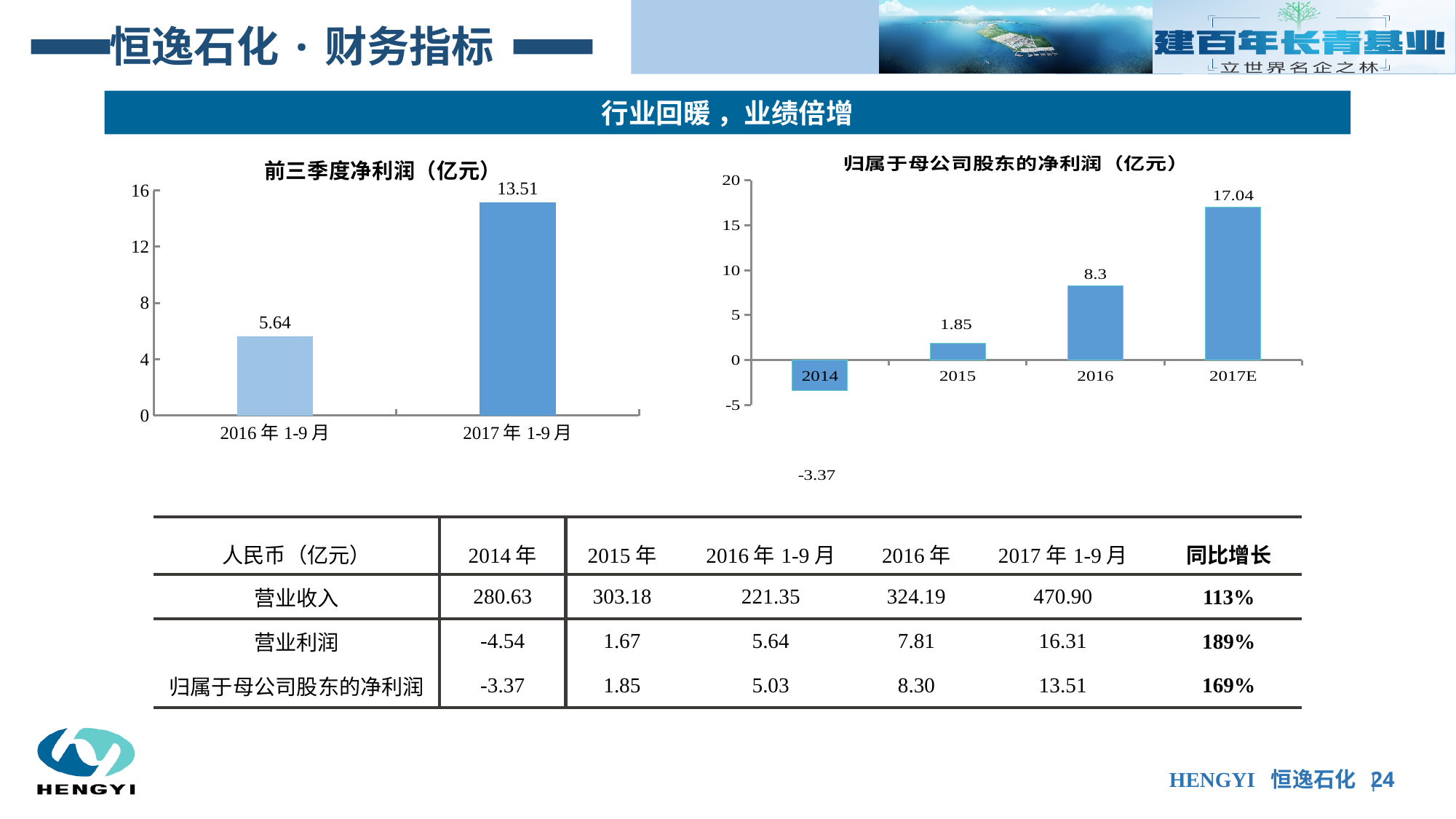
In the chart titled 归属于母公司股东的净利润（亿元）, do the values rise or fall from 2014 to 2017E? Rise What kind of chart is the one titled 前三季度净利润（亿元）? Bar chart In the chart titled 前三季度净利润（亿元）, what is the difference between the 2017年1-9月 and 2016年1-9月 values? 7.87 In the chart titled 前三季度净利润（亿元）, what is the value for 2017年1-9月? 13.51 In the chart titled 归属于母公司股东的净利润（亿元）, what is the value for 2017E? 17.04 In the chart titled 归属于母公司股东的净利润（亿元）, which year has the highest value? 2017E In the chart titled 前三季度净利润（亿元）, what is the value for 2016年1-9月? 5.64 In the chart titled 归属于母公司股东的净利润（亿元）, what is the difference between the 2016 and 2015 values? 6.45 In the chart titled 前三季度净利润（亿元）, how many bars are plotted? 2 In the chart titled 归属于母公司股东的净利润（亿元）, how many categories are shown on the x axis? 4 In the chart titled 归属于母公司股东的净利润（亿元）, which year has the lowest value? 2014 In the chart titled 归属于母公司股东的净利润（亿元）, what is the value for 2014? -3.37